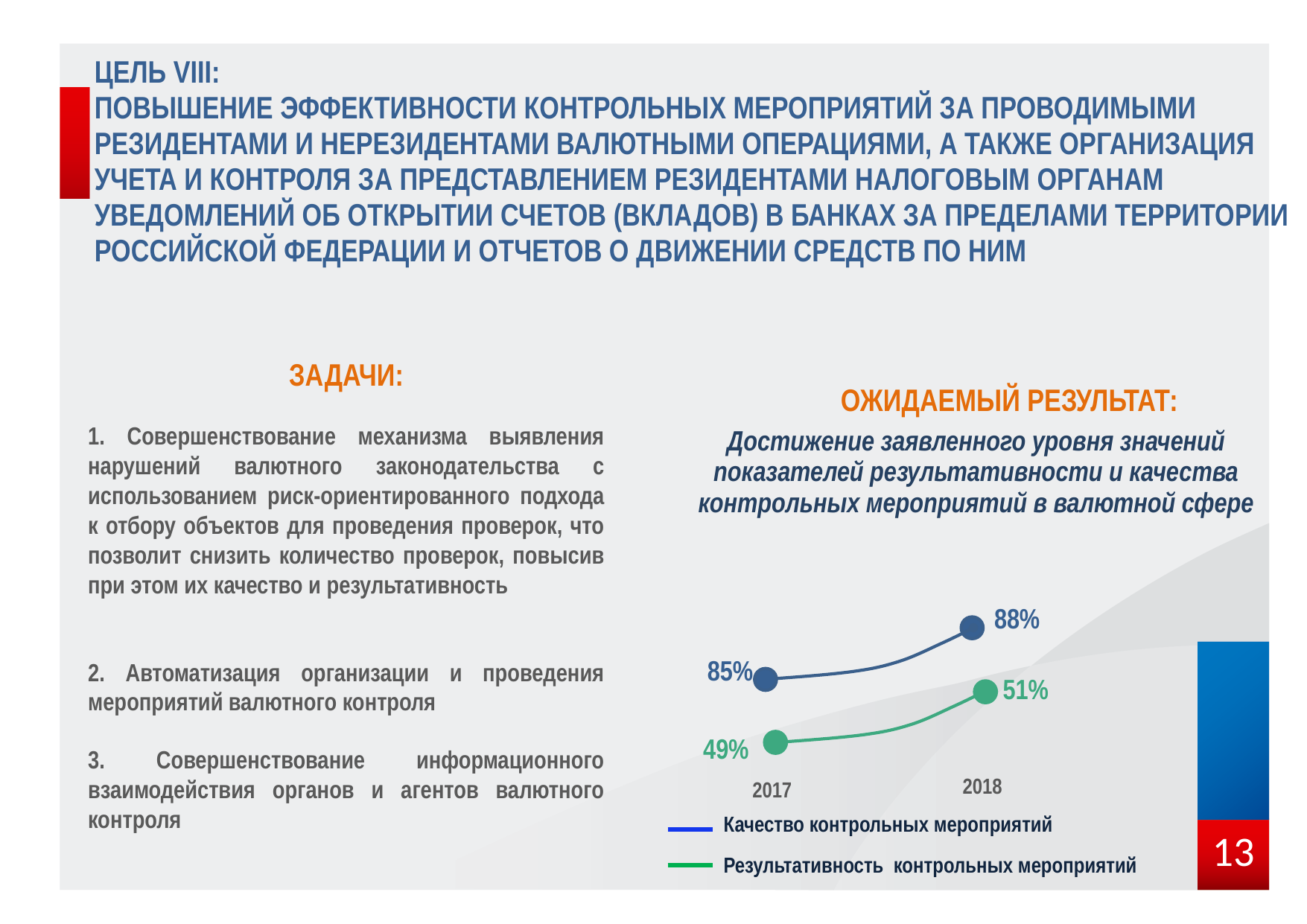
What is the difference between 'Качество контрольных мероприятий' and 'Результативность контрольных мероприятий' in 2018? 37 percentage points What is the value of 'Качество контрольных мероприятий' in 2018? 88% What kind of chart is shown on the slide? line chart How many years are shown on the x axis of the chart? 2 What is the value of 'Качество контрольных мероприятий' in 2017? 85% What is the value of 'Результативность контрольных мероприятий' in 2017? 49% Does 'Качество контрольных мероприятий' rise or fall from 2017 to 2018? rise What is the value of 'Результативность контрольных мероприятий' in 2018? 51% How many series does the legend list? 2 By how many percentage points does 'Результативность контрольных мероприятий' change from 2017 to 2018? 2 percentage points Which series has the higher value in 2017, 'Качество контрольных мероприятий' or 'Результативность контрольных мероприятий'? Качество контрольных мероприятий By how many percentage points does 'Качество контрольных мероприятий' change from 2017 to 2018? 3 percentage points